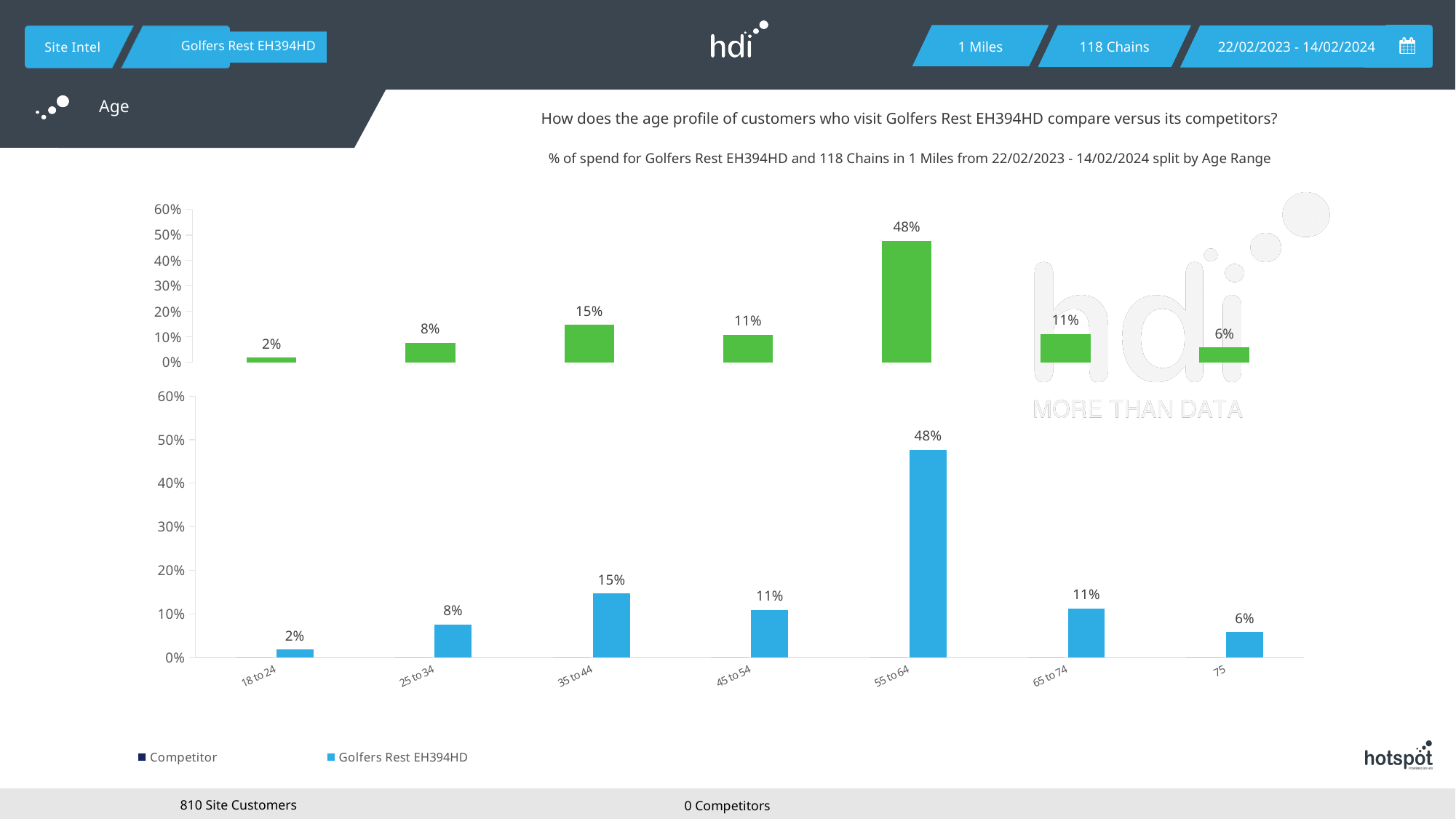
In the top chart, what is the value shown on the tallest bar? 48% What kind of chart is the bottom chart? bar chart How many series does the legend at the bottom of the slide list? 2 In the bottom chart, which is larger, the value for 35 to 44 or the value for 45 to 54? 35 to 44 In the bottom chart, is the value for 55 to 64 greater or less than 40%? greater In the bottom chart, which age range has the highest value? 55 to 64 In the bottom chart, which age range has the lowest value? 18 to 24 In the bottom chart, what is the difference between the values for 55 to 64 and 35 to 44? 33% In the bottom chart, what is the value for the 55 to 64 age range? 48% In the bottom chart, what is the value for the 75 age range? 6% In the bottom chart, what is the value for the 25 to 34 age range? 8% How many age range categories are shown on the x axis of the bottom chart? 7